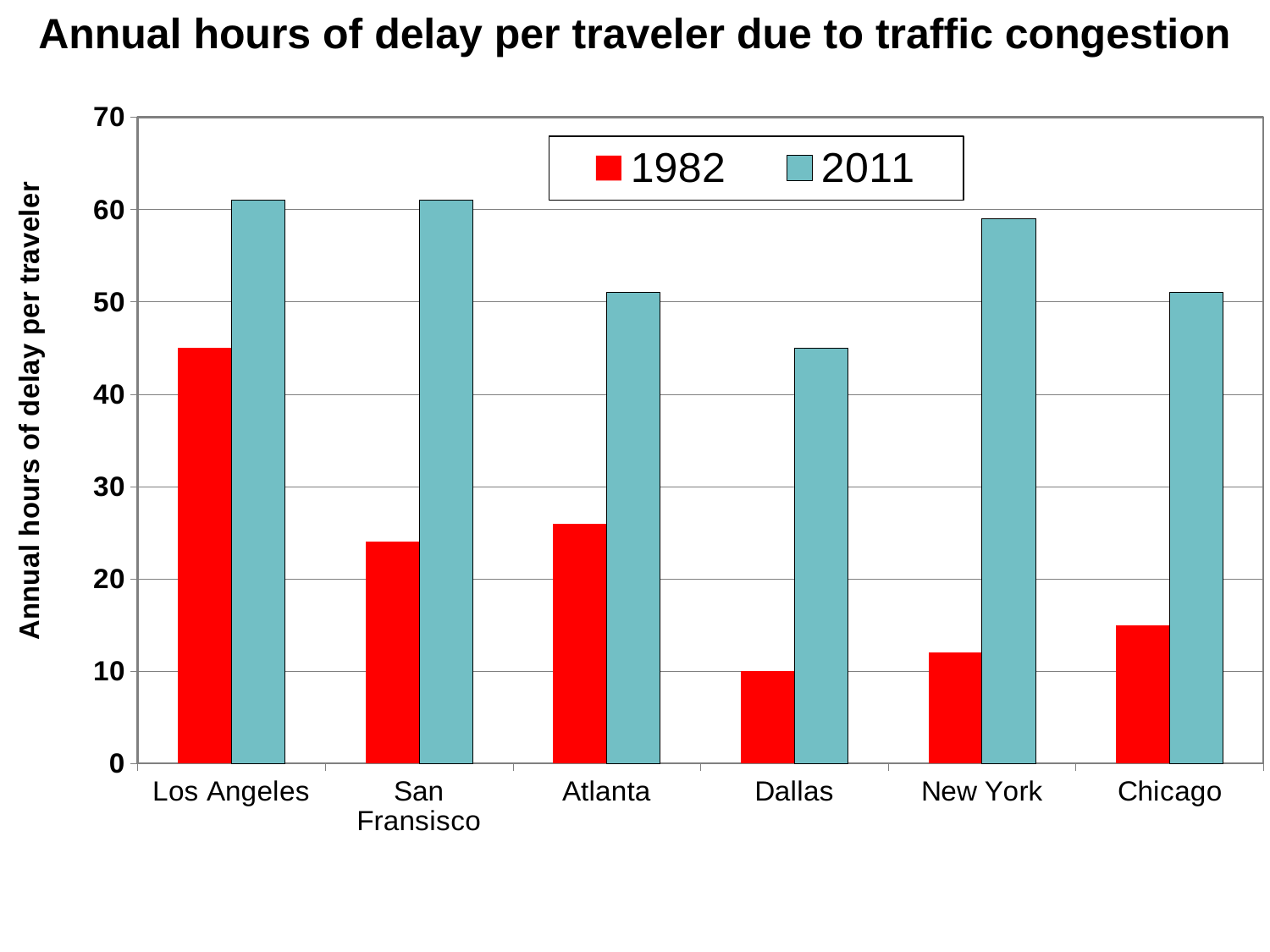
Is the 2011 value for New York greater or less than 50? greater Which is larger, the 2011 value for Atlanta or the 2011 value for Dallas? Atlanta Which city has the lowest 2011 value? Dallas What is the title of the chart? Annual hours of delay per traveler due to traffic congestion Is the 1982 value for Chicago greater or less than 20? less How many series does the legend list? 2 How many cities are shown on the x axis? 6 What type of chart is shown on the slide? bar chart Which is larger, the 1982 value for Los Angeles or the 1982 value for San Fransisco? Los Angeles Which city has the highest 1982 value? Los Angeles What is the 1982 value for Dallas? 10